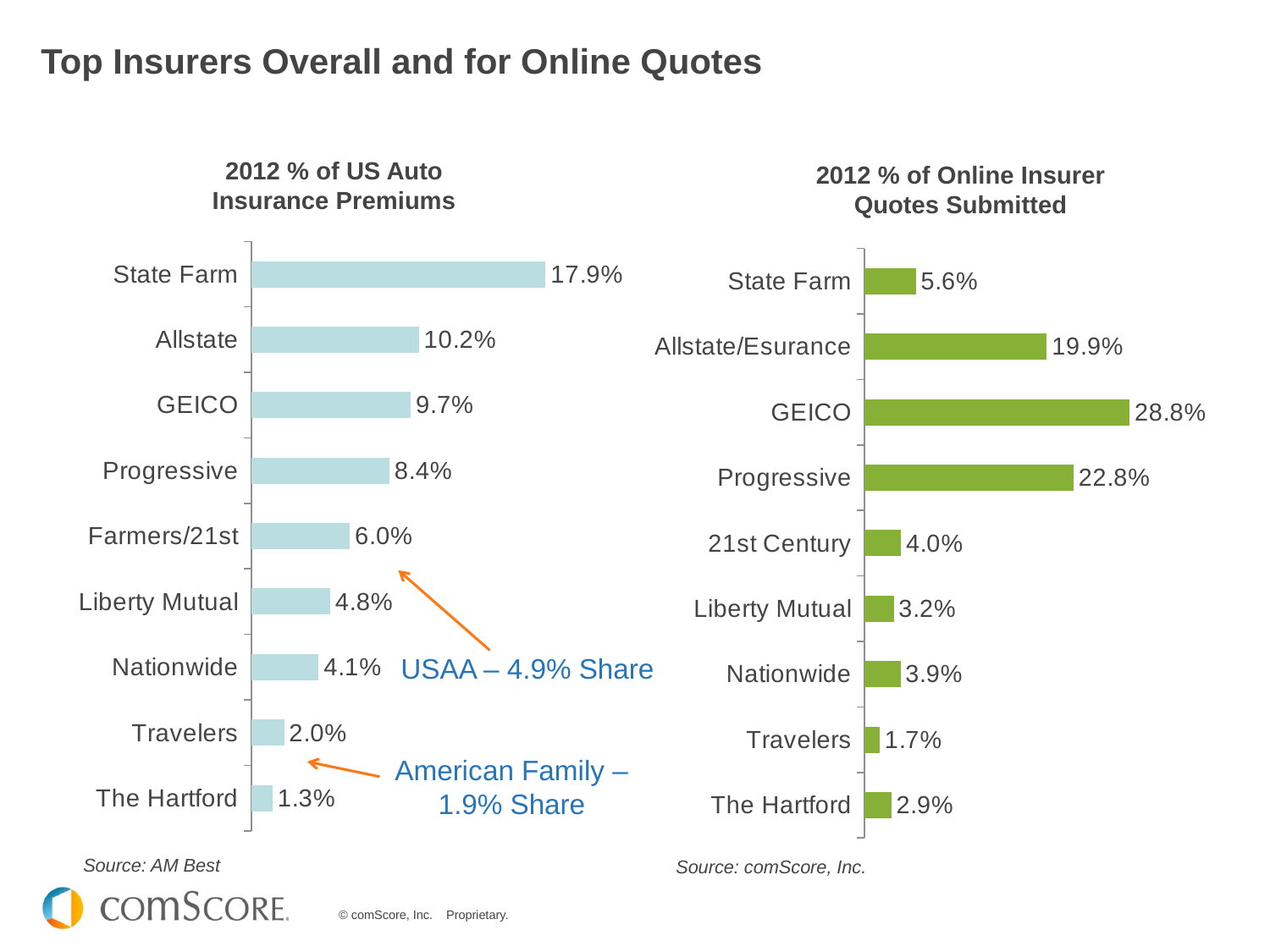
How many insurers are shown in the '2012 % of US Auto Insurance Premiums' chart? 9 In the '2012 % of US Auto Insurance Premiums' chart, which is larger, Liberty Mutual or Nationwide? Liberty Mutual In the '2012 % of US Auto Insurance Premiums' chart, what is the value for State Farm? 17.9% In the '2012 % of Online Insurer Quotes Submitted' chart, what is the value for Progressive? 22.8% In the '2012 % of Online Insurer Quotes Submitted' chart, which insurer has the lowest value? Travelers In the '2012 % of US Auto Insurance Premiums' chart, which insurer has the lowest value? The Hartford In the '2012 % of Online Insurer Quotes Submitted' chart, which insurer has the highest value? GEICO In the '2012 % of Online Insurer Quotes Submitted' chart, which is larger, Allstate/Esurance or Progressive? Progressive What kind of chart is the '2012 % of Online Insurer Quotes Submitted' chart? Bar chart In the '2012 % of US Auto Insurance Premiums' chart, what is the difference between Allstate and GEICO? 0.5% According to the annotation on the '2012 % of US Auto Insurance Premiums' chart, what share does USAA have? 4.9% In the '2012 % of Online Insurer Quotes Submitted' chart, what is the difference between GEICO and State Farm? 23.2%